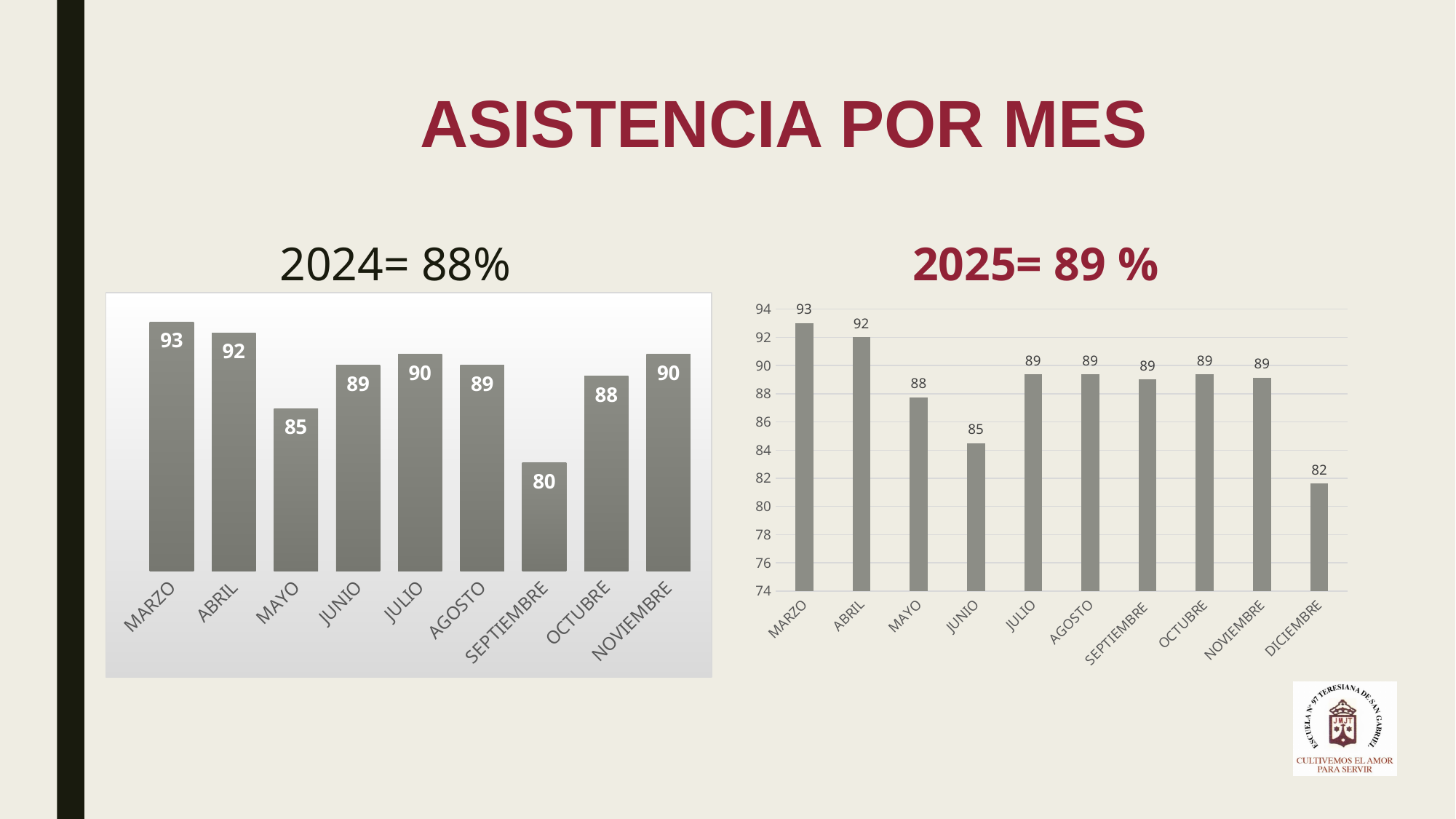
What is the title of the slide? ASISTENCIA POR MES In the 2024 chart, what is the difference between the values for MARZO and MAYO? 8 In the 2024 chart, how many months are shown? 9 What kind of chart is the 2025 chart? Bar chart In the 2025 chart, how many months are shown? 10 In the 2025 chart, what is the value for DICIEMBRE? 82 In the 2024 chart, what is the value for SEPTIEMBRE? 80 In the 2025 chart, which month has the lowest value? DICIEMBRE In the 2025 chart, which is larger, the value for MAYO or the value for JUNIO? MAYO In the 2025 chart, what is the difference between the values for ABRIL and DICIEMBRE? 10 In the 2024 chart, which month has the lowest value? SEPTIEMBRE In the 2024 chart, which month has the highest value? MARZO